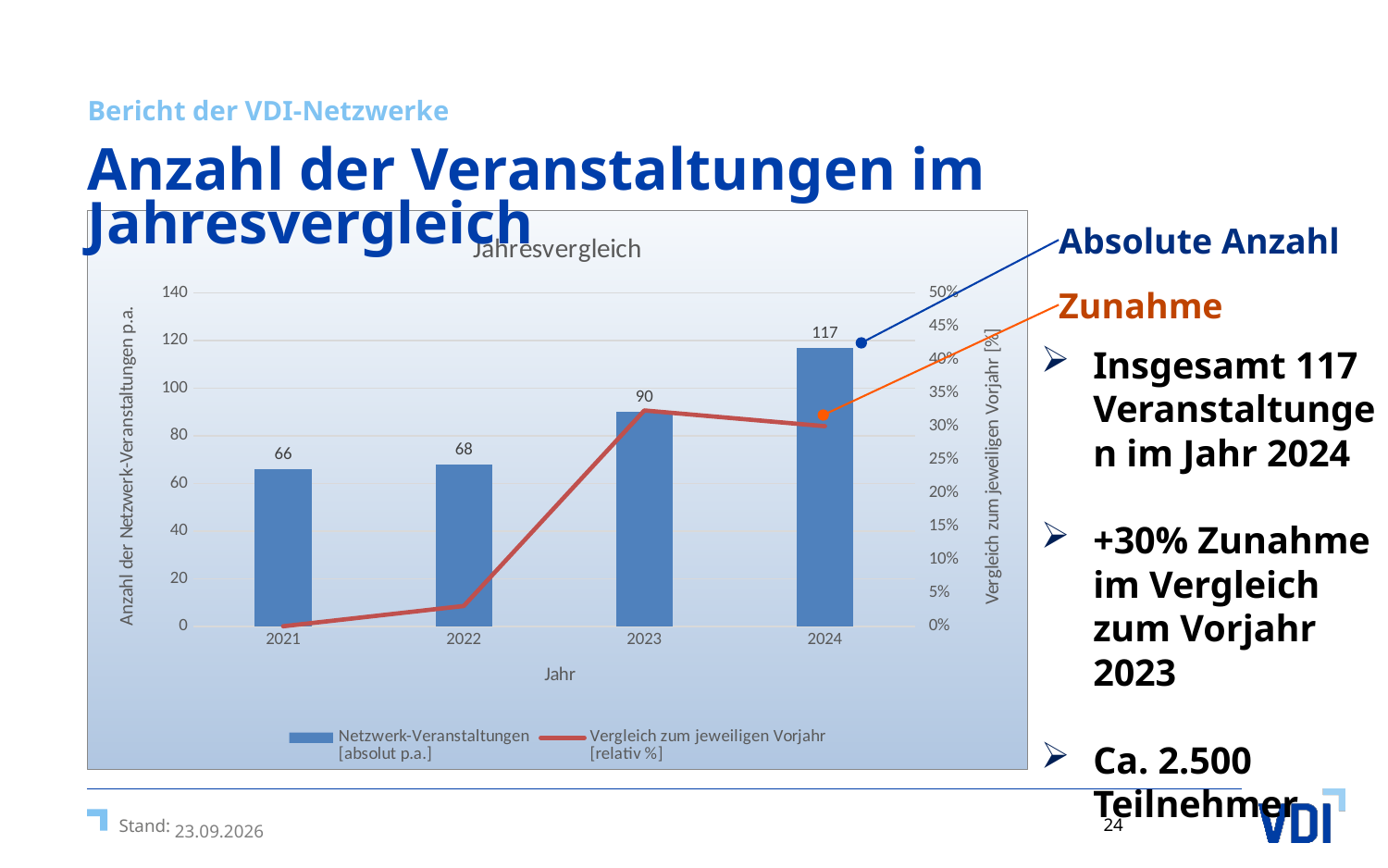
Which year has more Netzwerk-Veranstaltungen, 2022 or 2023? 2023 How many series does the chart legend list? 2 Do the Netzwerk-Veranstaltungen values rise or fall from 2021 to 2024? rise Which year has the highest number of Netzwerk-Veranstaltungen? 2024 What is the value of Netzwerk-Veranstaltungen [absolut p.a.] for 2021? 66 What is the difference in Netzwerk-Veranstaltungen between 2024 and 2023? 27 What kind of chart is used for the Netzwerk-Veranstaltungen [absolut p.a.] series? bar chart What is the value of Netzwerk-Veranstaltungen [absolut p.a.] for 2023? 90 What is the value of Netzwerk-Veranstaltungen [absolut p.a.] for 2024? 117 Which year has the lowest number of Netzwerk-Veranstaltungen? 2021 Is the value of Vergleich zum jeweiligen Vorjahr [relativ %] for 2022 greater or less than 10%? less How many years are shown on the x axis of the chart? 4